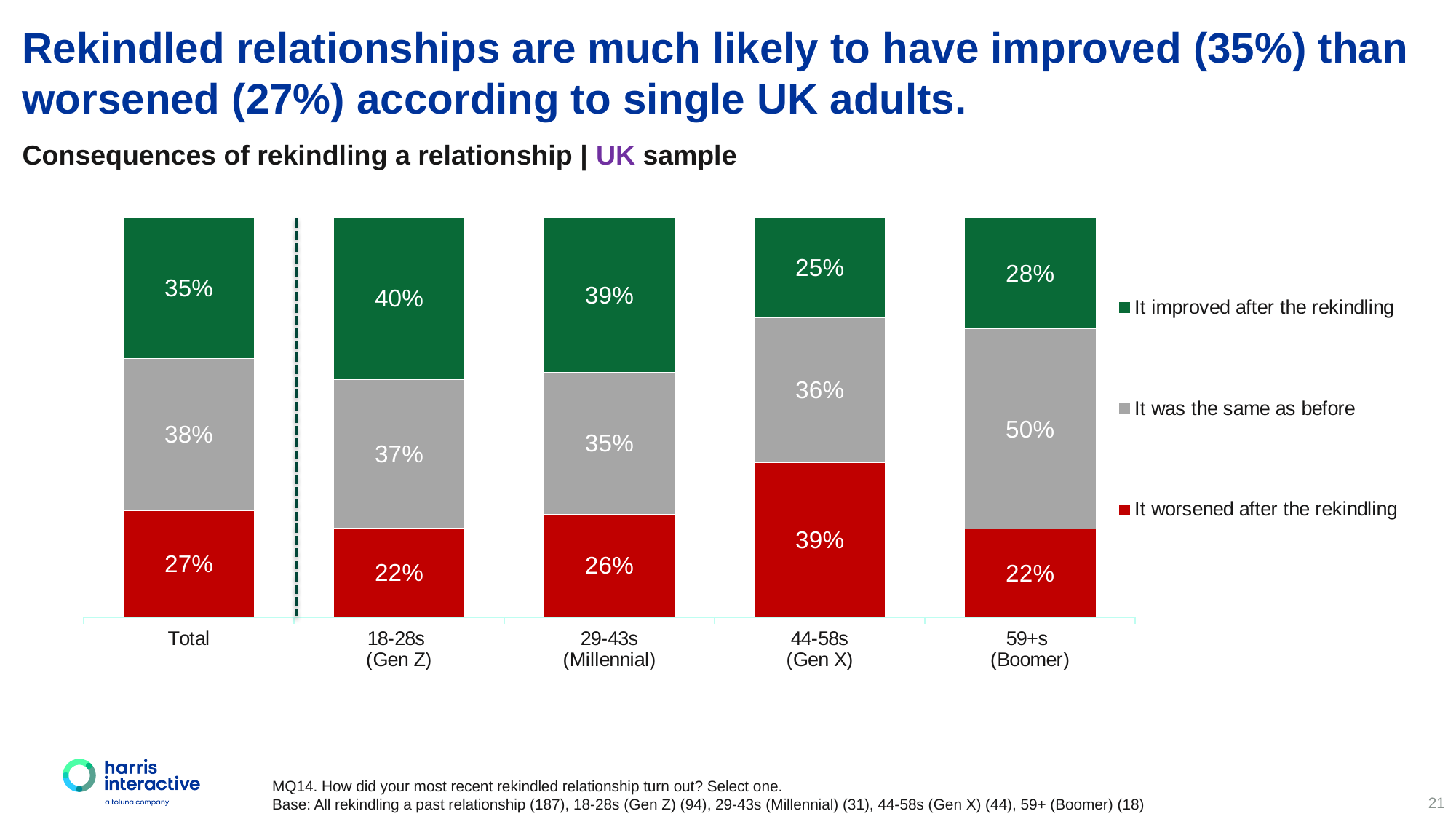
What percentage of the Total group said the relationship improved after the rekindling? 35% What percentage of 59+s (Boomer) said it was the same as before? 50% Which colour represents 'It worsened after the rekindling' in the legend? Red Which age group has the highest share saying the relationship improved after the rekindling? 18-28s (Gen Z) How many series does the legend list? 3 What kind of chart is shown on the slide? Stacked bar chart What is the total of the stacked bar for 29-43s (Millennial)? 100% What percentage of 44-58s (Gen X) said the relationship worsened after the rekindling? 39% What is the difference between the 'It improved' share for 18-28s (Gen Z) and for 44-58s (Gen X)? 15 percentage points Which age group has the lowest share saying the relationship improved after the rekindling? 44-58s (Gen X) How many age groups (including Total) are shown on the x axis? 5 Which is larger: the 'It worsened' share for 29-43s (Millennial) or for 59+s (Boomer)? 29-43s (Millennial)